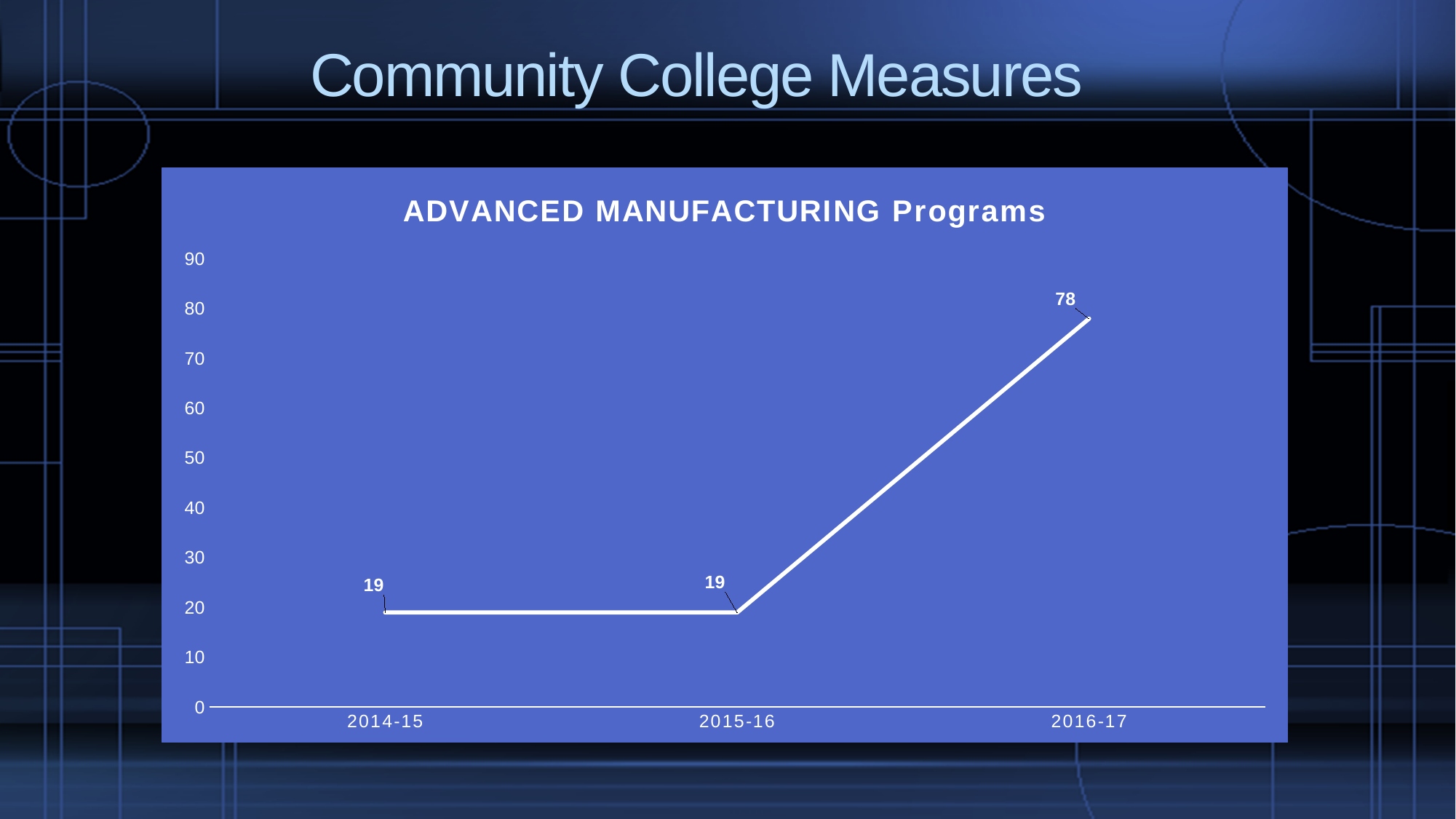
What is the value for 2016-17? 78 Which year has the highest value? 2016-17 How many years are shown on the x axis? 3 Which is larger, the value for 2016-17 or the value for 2014-15? 2016-17 What is the value for 2015-16? 19 What is the difference between the values for 2016-17 and 2015-16? 59 Is the value for 2016-17 greater or less than 70? greater What is the value for 2014-15? 19 Is the value for 2014-15 greater or less than 30? less What kind of chart is shown? line chart Does the value rise or fall from 2015-16 to 2016-17? rise What is the title of the chart? ADVANCED MANUFACTURING Programs